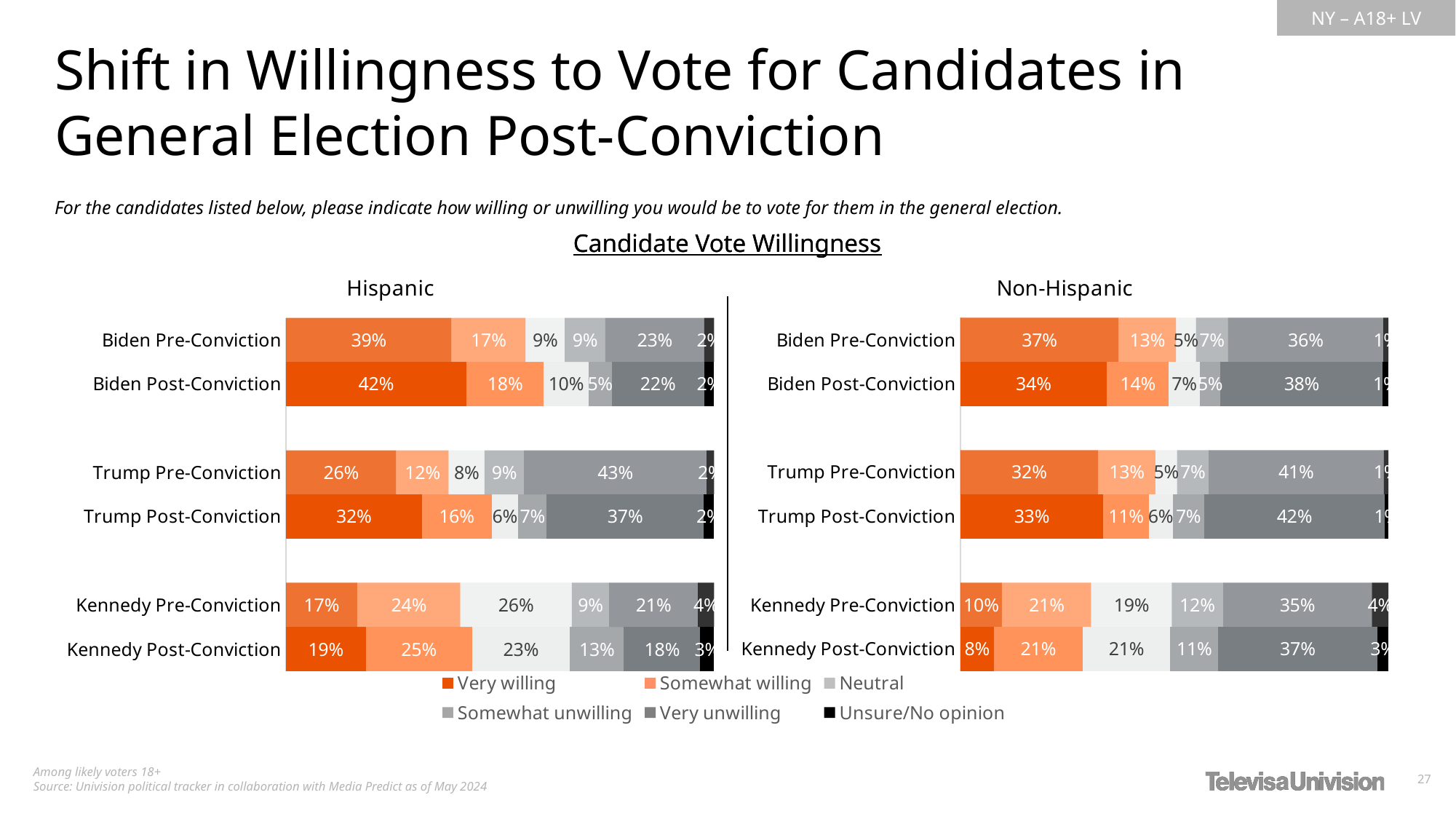
In the Non-Hispanic chart, what is the Somewhat willing value for Kennedy Post-Conviction? 21% What kind of chart is used on this slide? Stacked bar chart In the Non-Hispanic chart, what is the Very unwilling value for Trump Post-Conviction? 42% In the Hispanic chart, what is the Very willing value for Biden Post-Conviction? 42% In the Hispanic chart, which has the larger Neutral value: Kennedy Pre-Conviction or Kennedy Post-Conviction? Kennedy Pre-Conviction What colour represents Very willing in the legend? Dark orange How many series does the legend list? 6 In the Hispanic chart, which bar has the lowest Very willing value? Kennedy Pre-Conviction In the Hispanic chart, which bar has the highest Very willing value? Biden Post-Conviction In the Hispanic chart, by how many percentage points did Trump's Very willing value change from Pre-Conviction to Post-Conviction? 6 percentage points How many bars are shown in the Hispanic chart? 6 In the Non-Hispanic chart, what is the difference between the Very unwilling values for Kennedy Post-Conviction and Kennedy Pre-Conviction? 2 percentage points